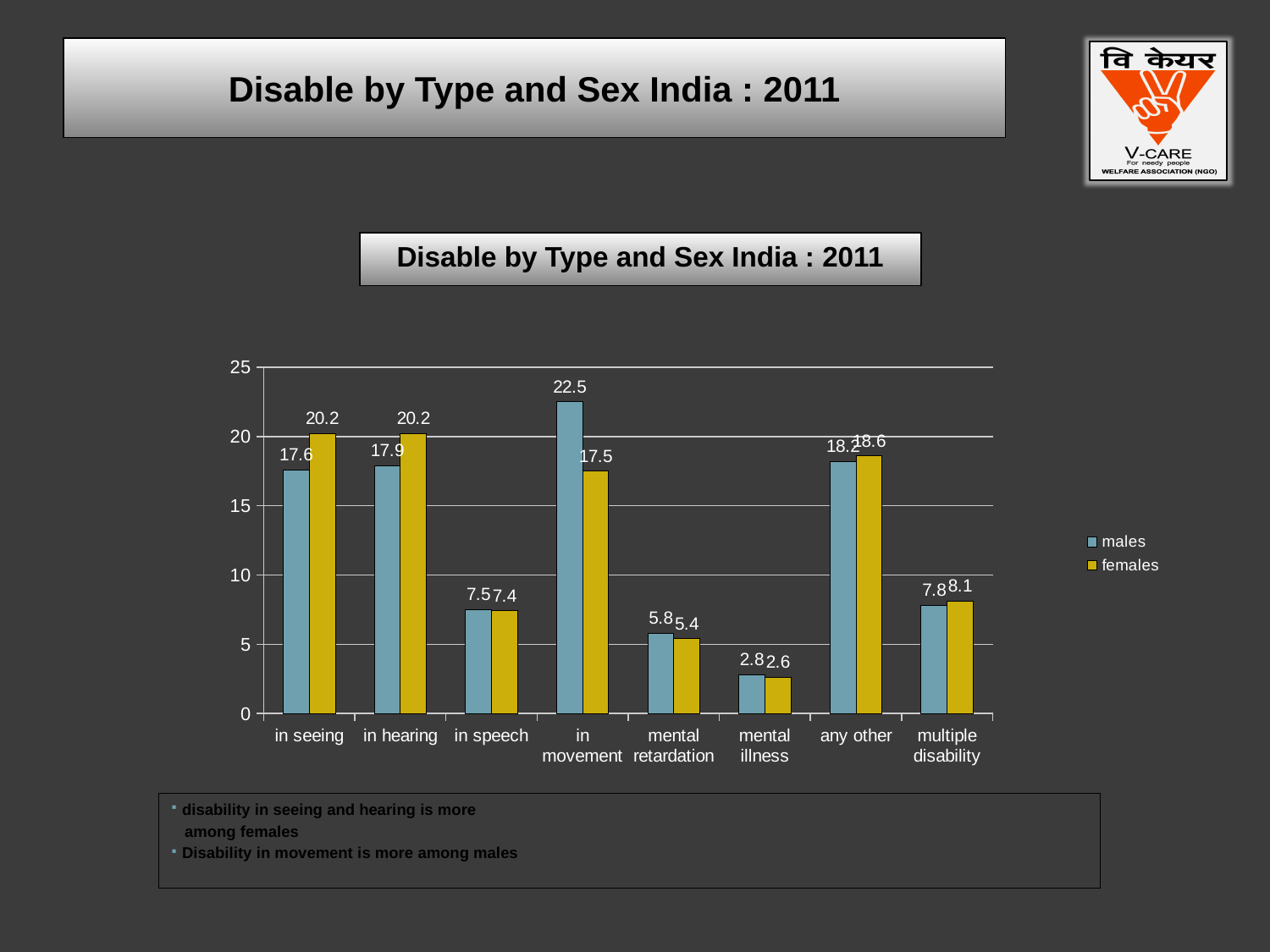
What is the difference between the females and males values in the 'in seeing' category? 2.6 Is the value for males in the 'in speech' category greater or less than 10? less What is the value for females in the 'multiple disability' category? 8.1 Which category has the lowest value for females? mental illness How many series does the legend list? 2 What is the difference between the males and females values in the 'in movement' category? 5 What is the value for males in the 'in movement' category? 22.5 How many disability categories are shown on the x axis? 8 Which is larger in the 'in hearing' category, the value for males or for females? females What is the value for females in the 'in seeing' category? 20.2 Which category has the highest value for males? in movement What kind of chart is shown on the slide? bar chart